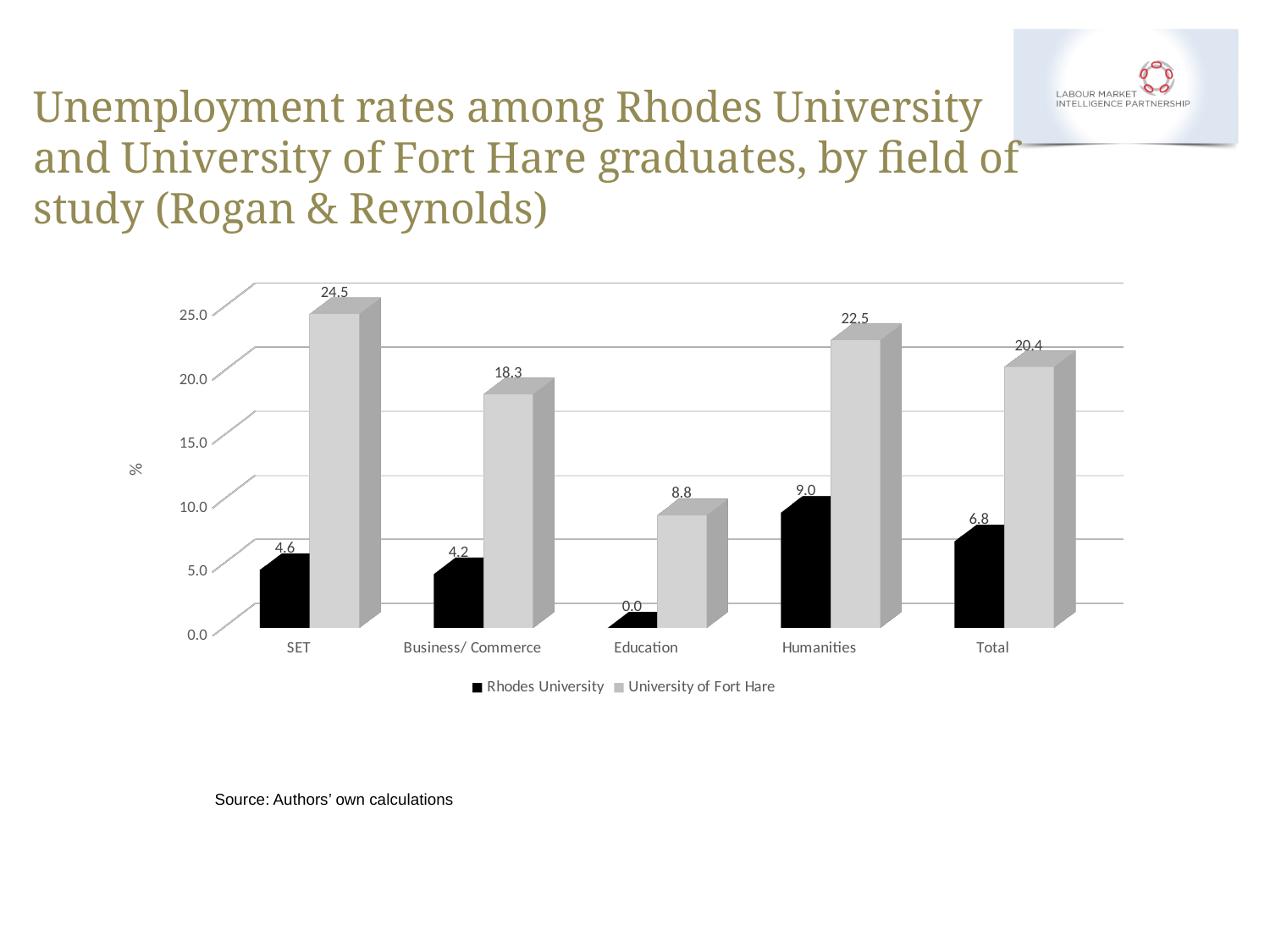
What is the unemployment rate for Rhodes University graduates in SET? 4.6 Which is larger, the Rhodes University unemployment rate in SET or in Business/ Commerce? SET What kind of chart is shown on the slide? Bar chart What is the Total unemployment rate for University of Fort Hare graduates? 20.4 Which field of study has the highest unemployment rate for University of Fort Hare graduates? SET Which series is shown in black in the chart? Rhodes University What is the difference between the University of Fort Hare and Rhodes University unemployment rates in Humanities? 13.5 What is the unemployment rate for Rhodes University graduates in Education? 0.0 How many series does the legend list? 2 What is the unemployment rate for University of Fort Hare graduates in Business/ Commerce? 18.3 Which field of study has the lowest unemployment rate for Rhodes University graduates? Education How many fields of study (categories) are shown on the x axis? 5